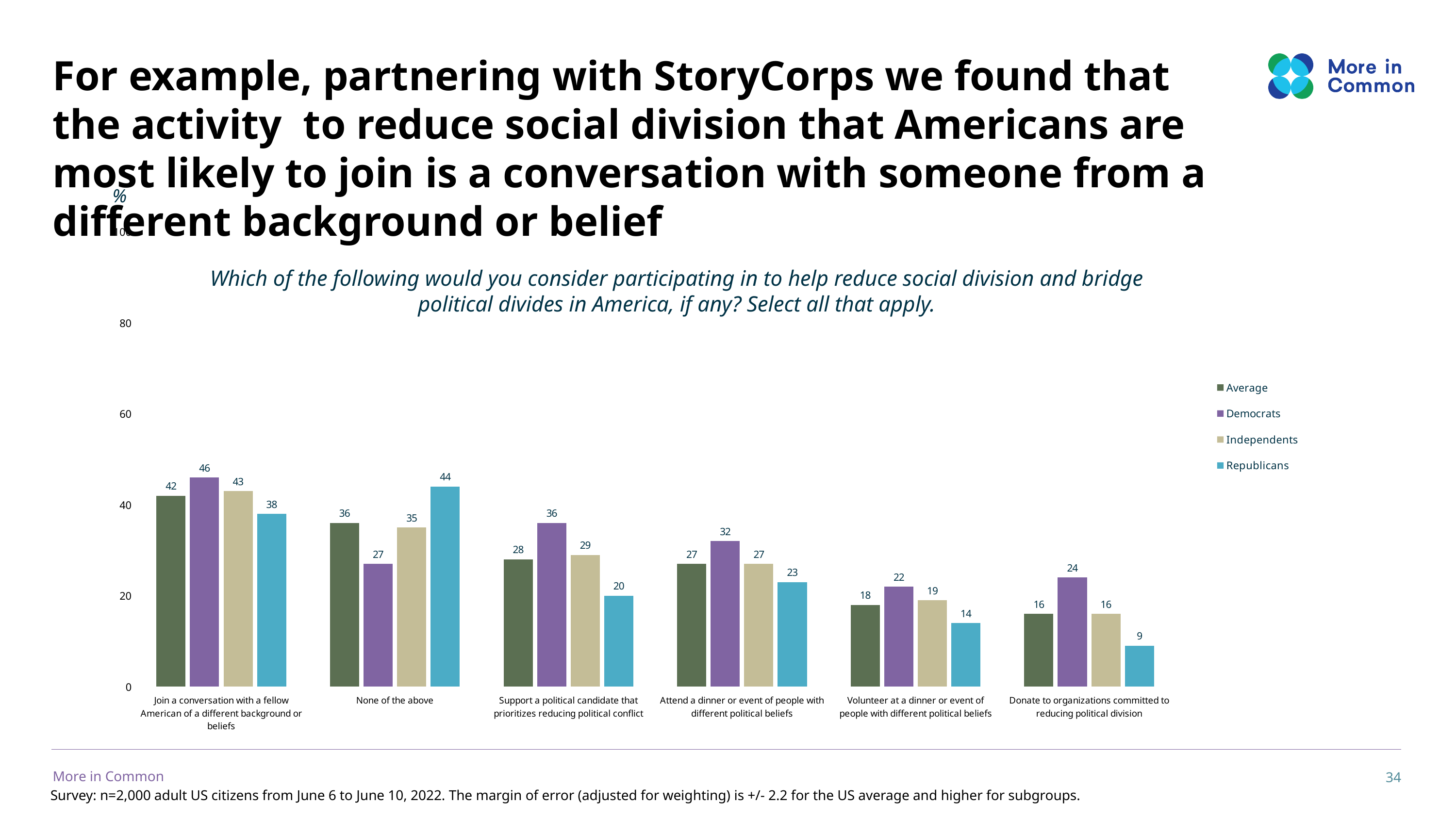
What is the difference between the Democrats and Republicans values for "Donate to organizations committed to reducing political division"? 15 For "Attend a dinner or event of people with different political beliefs", which is larger: the Democrats value or the Republicans value? Democrats Which series is shown in purple in the legend? Democrats What is the Republicans value for "None of the above"? 44 How many series does the legend list? 4 What is the Average value for "Support a political candidate that prioritizes reducing political conflict"? 28 What is the Democrats value for "Join a conversation with a fellow American of a different background or beliefs"? 46 What is the Independents value for "Volunteer at a dinner or event of people with different political beliefs"? 19 Which category has the highest Average value? Join a conversation with a fellow American of a different background or beliefs Which category has the lowest Republicans value? Donate to organizations committed to reducing political division What kind of chart is shown on the slide? Bar chart How many categories are shown on the x axis? 6